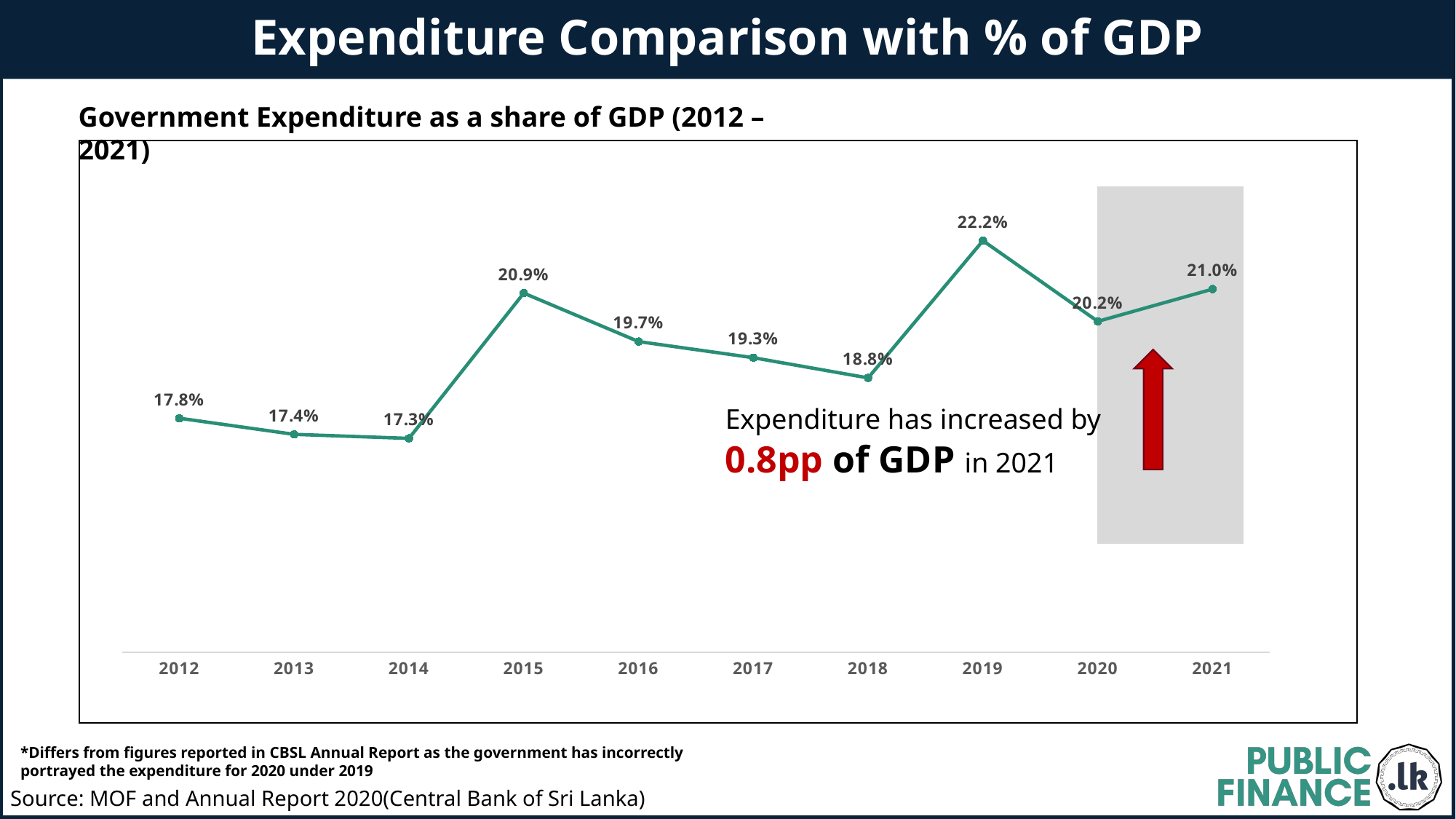
What type of chart is shown on the slide? Line chart How many years are plotted on the chart? 10 Which year had the highest government expenditure as a share of GDP? 2019 Which year had the lowest government expenditure as a share of GDP? 2014 Did expenditure as a share of GDP rise or fall from 2012 to 2014? Fall What was government expenditure as a share of GDP in 2021? 21.0% What is the title of the chart? Government Expenditure as a share of GDP (2012 – 2021) What was government expenditure as a share of GDP in 2012? 17.8% What is the difference between the 2019 and 2018 values? 3.4 percentage points By how many percentage points did expenditure as a share of GDP change from 2020 to 2021? 0.8pp Which year had a higher expenditure share of GDP, 2016 or 2017? 2016 What was government expenditure as a share of GDP in 2015? 20.9%